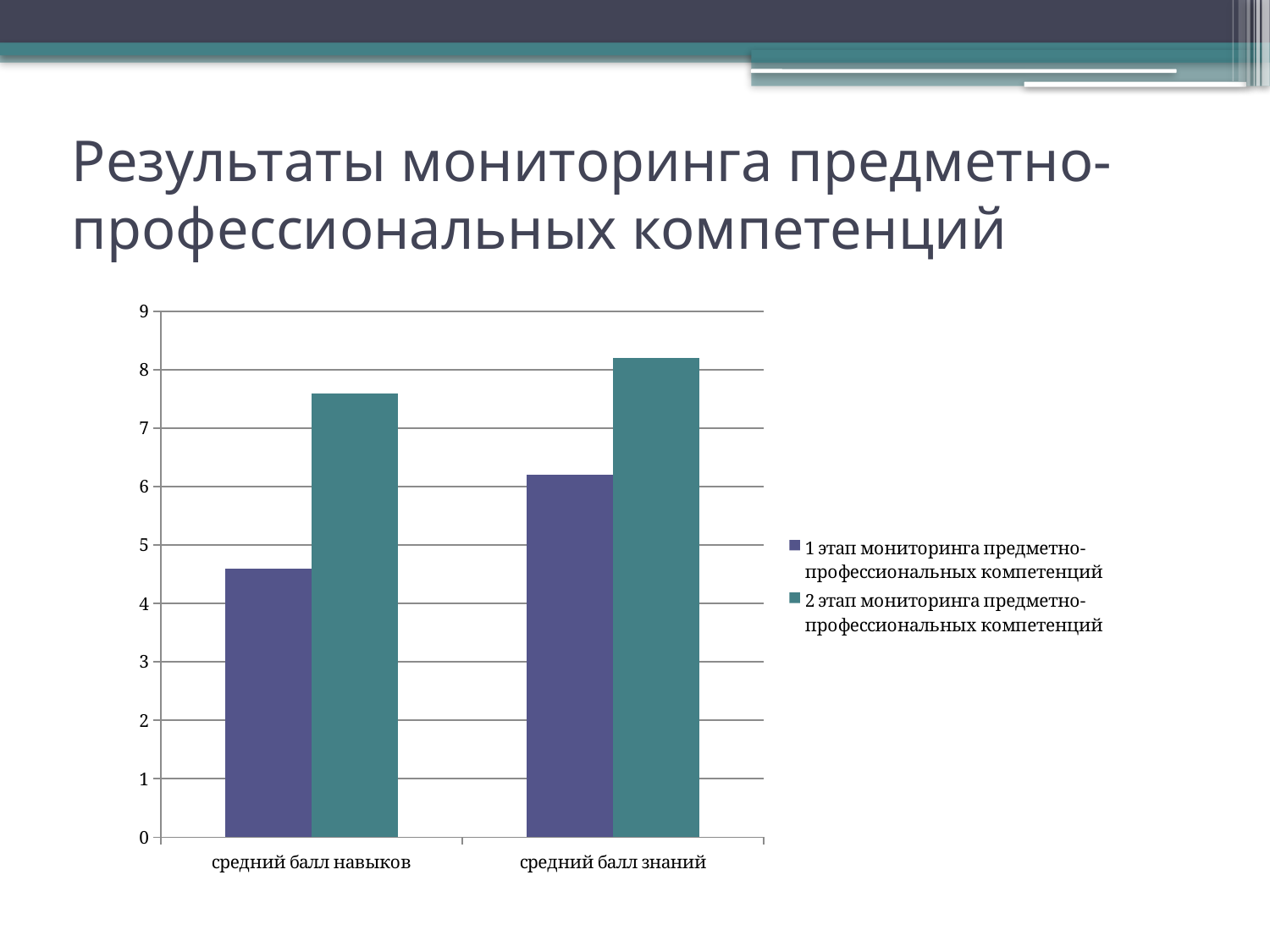
Is the value for 'средний балл знаний' in the series '1 этап мониторинга предметно-профессиональных компетенций' greater or less than 6? greater Which category has the lower value in the series '1 этап мониторинга предметно-профессиональных компетенций'? средний балл навыков Is the value for 'средний балл навыков' in the series '1 этап мониторинга предметно-профессиональных компетенций' greater or less than 5? less How many categories are shown on the x axis of the chart? 2 What is the highest value shown on the chart's vertical axis? 9 Is the value for 'средний балл знаний' in the series '2 этап мониторинга предметно-профессиональных компетенций' greater or less than 8? greater What kind of chart is shown on the slide? bar chart What is the title of the slide containing the chart? Результаты мониторинга предметно-профессиональных компетенций How many series does the chart's legend list? 2 For 'средний балл навыков', which series has the larger value? 2 этап мониторинга предметно-профессиональных компетенций Which category has the higher value in the series '2 этап мониторинга предметно-профессиональных компетенций'? средний балл знаний